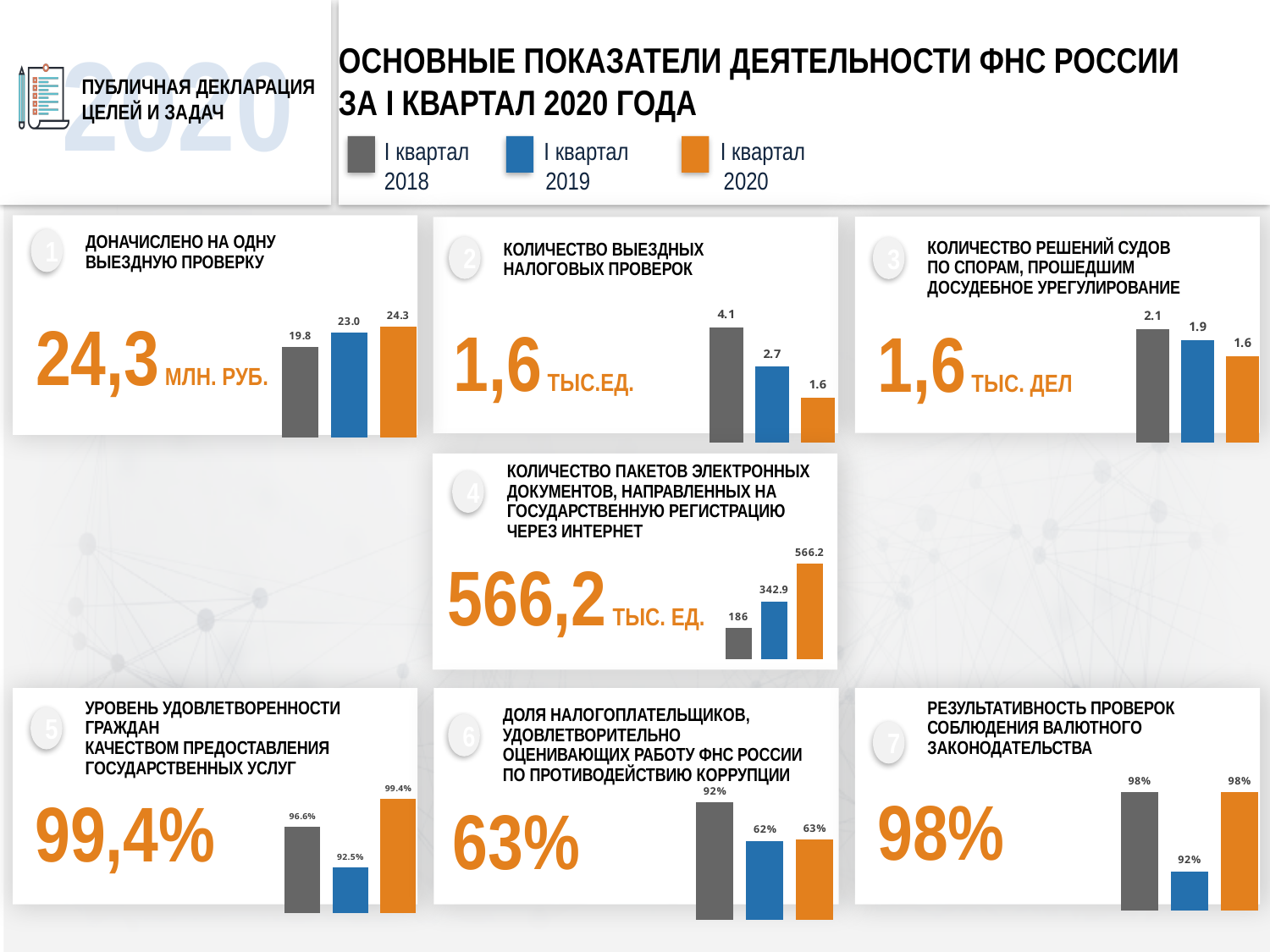
In chart 7 (Результативность проверок соблюдения валютного законодательства), what is the value for I квартал 2019? 92% In chart 3 (Количество решений судов по спорам, прошедшим досудебное урегулирование), what is the value for I квартал 2019? 1.9 In chart 1 (Доначислено на одну выездную проверку), what is the difference between the I квартал 2020 and I квартал 2018 values? 4.5 In chart 2 (Количество выездных налоговых проверок), do the values rise or fall from I квартал 2018 to I квартал 2020? fall In chart 1 (Доначислено на одну выездную проверку), what is the value for I квартал 2020? 24.3 What type of chart is used in chart 4 (Количество пакетов электронных документов)? bar chart In chart 6 (Доля налогоплательщиков, удовлетворительно оценивающих работу ФНС России), which is larger: the value for I квартал 2018 or I квартал 2020? I квартал 2018 In chart 2 (Количество выездных налоговых проверок), which quarter has the highest value? I квартал 2018 In chart 4 (Количество пакетов электронных документов), what is the value for I квартал 2018? 186 In chart 4 (Количество пакетов электронных документов), what is the difference between the I квартал 2020 and I квартал 2019 values? 223.3 How many series does the legend at the top of the slide list? 3 In chart 5 (Уровень удовлетворенности граждан), which quarter has the lowest value? I квартал 2019